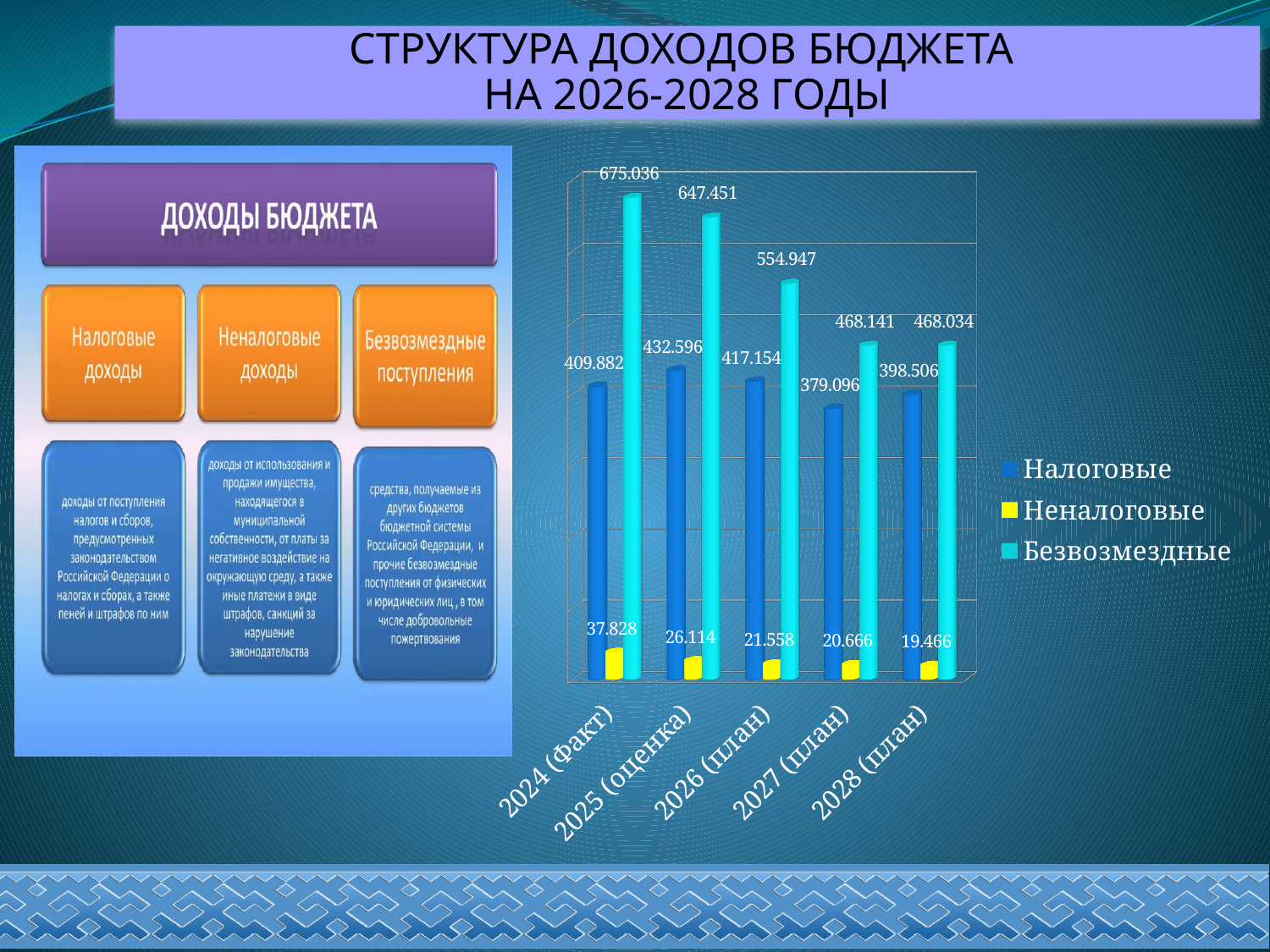
What is the difference between the Безвозмездные values for 2024 (факт) and 2025 (оценка)? 27.585 Which is larger, the Налоговые value for 2025 (оценка) or for 2026 (план)? 2025 (оценка) What is the difference between the Налоговые values for 2025 (оценка) and 2024 (факт)? 22.714 What kind of chart is shown on the slide? bar chart In which year is the Налоговые value lowest? 2027 (план) How many series does the chart legend list? 3 In which year is the Безвозмездные value highest? 2024 (факт) What is the value of Безвозмездные for 2026 (план)? 554.947 What is the value of Налоговые for 2024 (факт)? 409.882 How many years (categories) are shown on the x axis of the chart? 5 What is the value of Неналоговые for 2028 (план)? 19.466 Do the Неналоговые values rise or fall from 2024 (факт) to 2028 (план)? fall